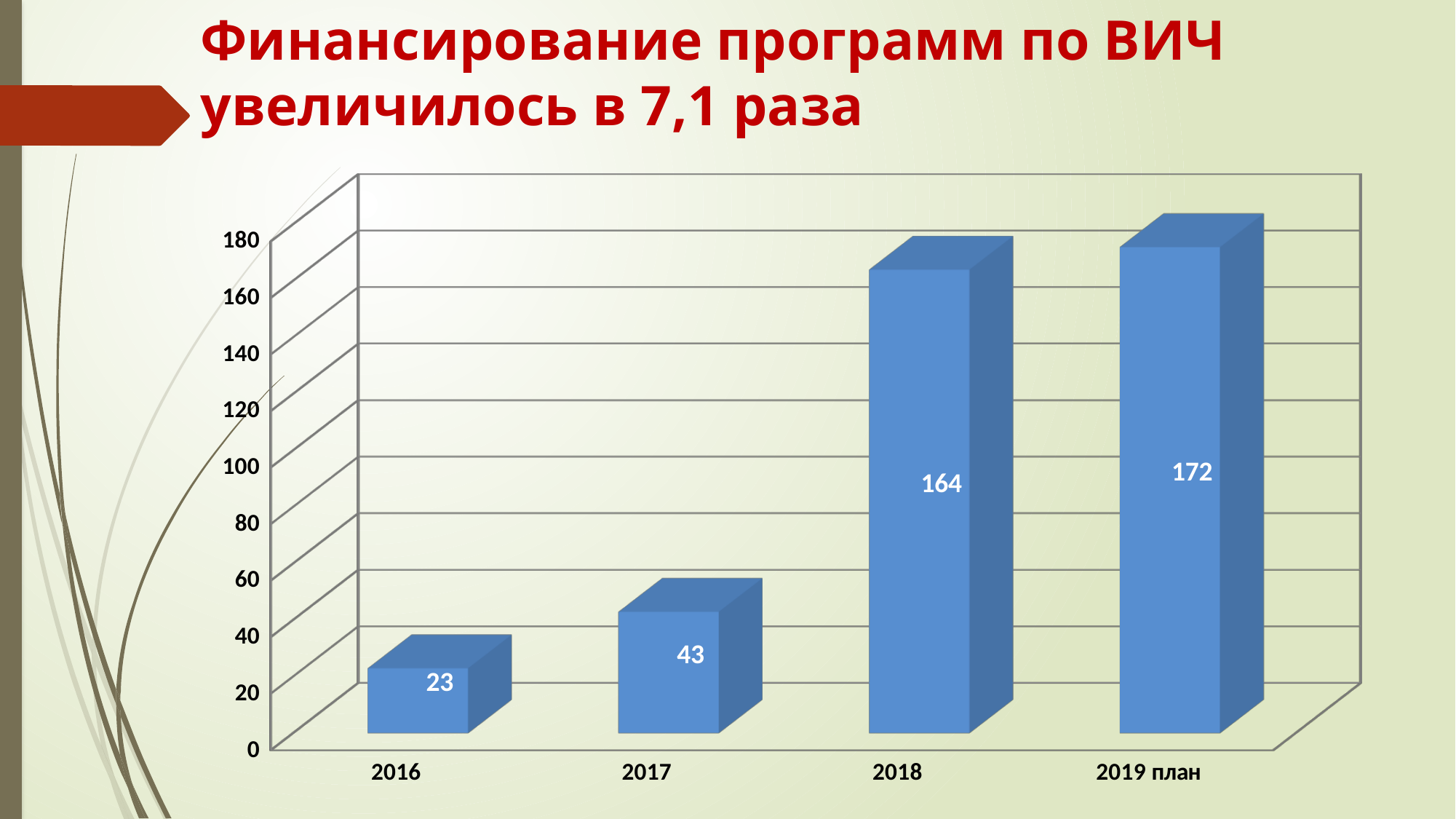
What is the difference between the values for 2019 план and 2018? 8 Do the values rise or fall from 2016 to 2019 план? rise How many categories are shown on the x axis? 4 What is the value for 2016? 23 Which category has the lowest value? 2016 What is the value for 2019 план? 172 What is the value for 2018? 164 Which category has the highest value? 2019 план Which is larger, the value for 2017 or the value for 2016? 2017 What kind of chart is shown on the slide? bar chart What is the difference between the values for 2018 and 2017? 121 What is the value for 2017? 43